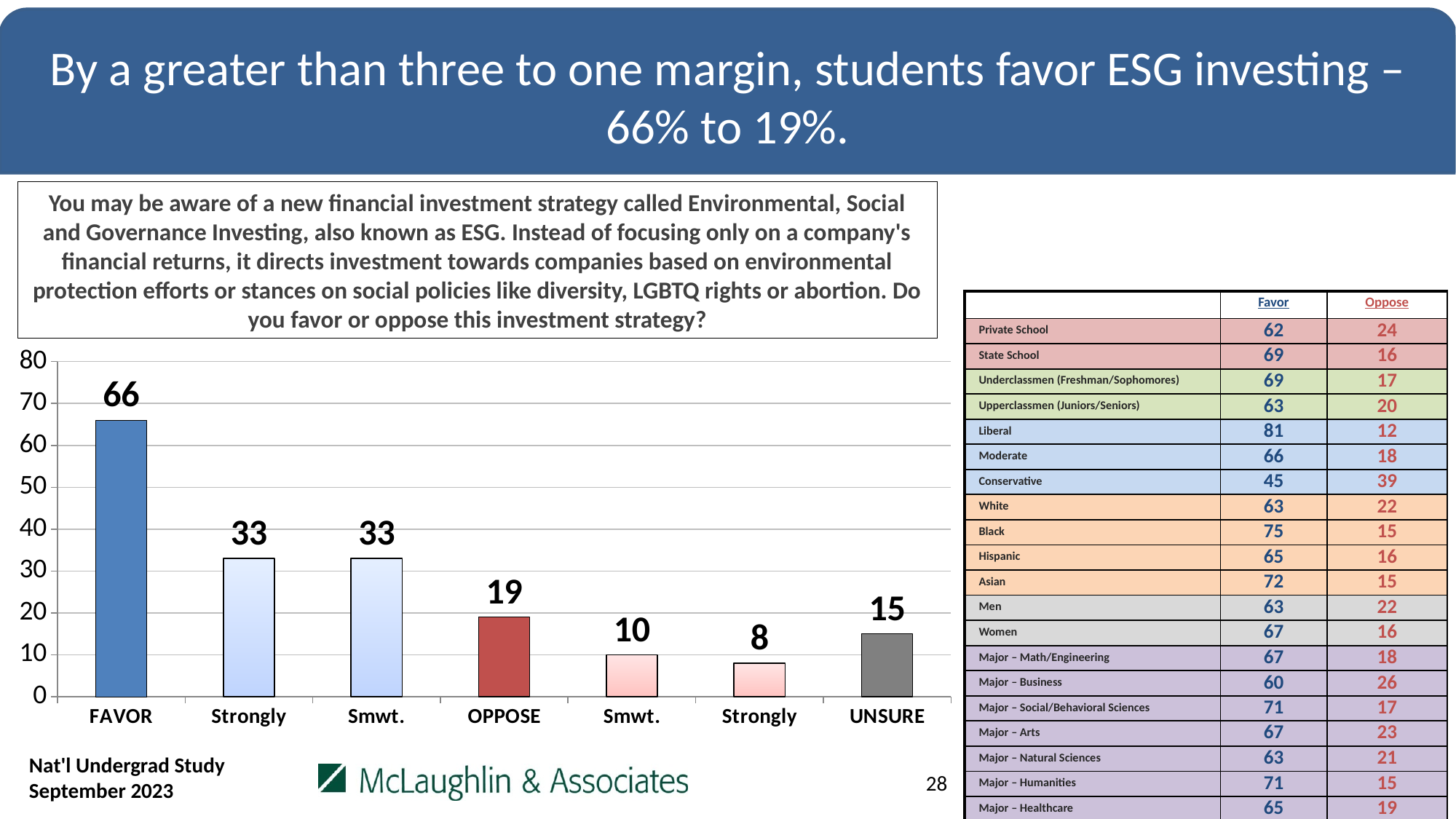
What is the difference between the FAVOR bar and the OPPOSE bar? 47 What is the value of the OPPOSE bar? 19 What is the highest value shown on the vertical axis? 80 Which category has the highest bar? FAVOR Is the value of the FAVOR bar greater or less than 60? greater What is the value of the Strongly bar on the oppose side (the rightmost Strongly bar)? 8 What is the value of the FAVOR bar? 66 Which is larger, the OPPOSE bar or the UNSURE bar? OPPOSE What is the value of the UNSURE bar? 15 Which category has the lowest bar? Strongly (oppose) How many bars are shown in the chart? 7 What type of chart is shown on the slide? bar chart